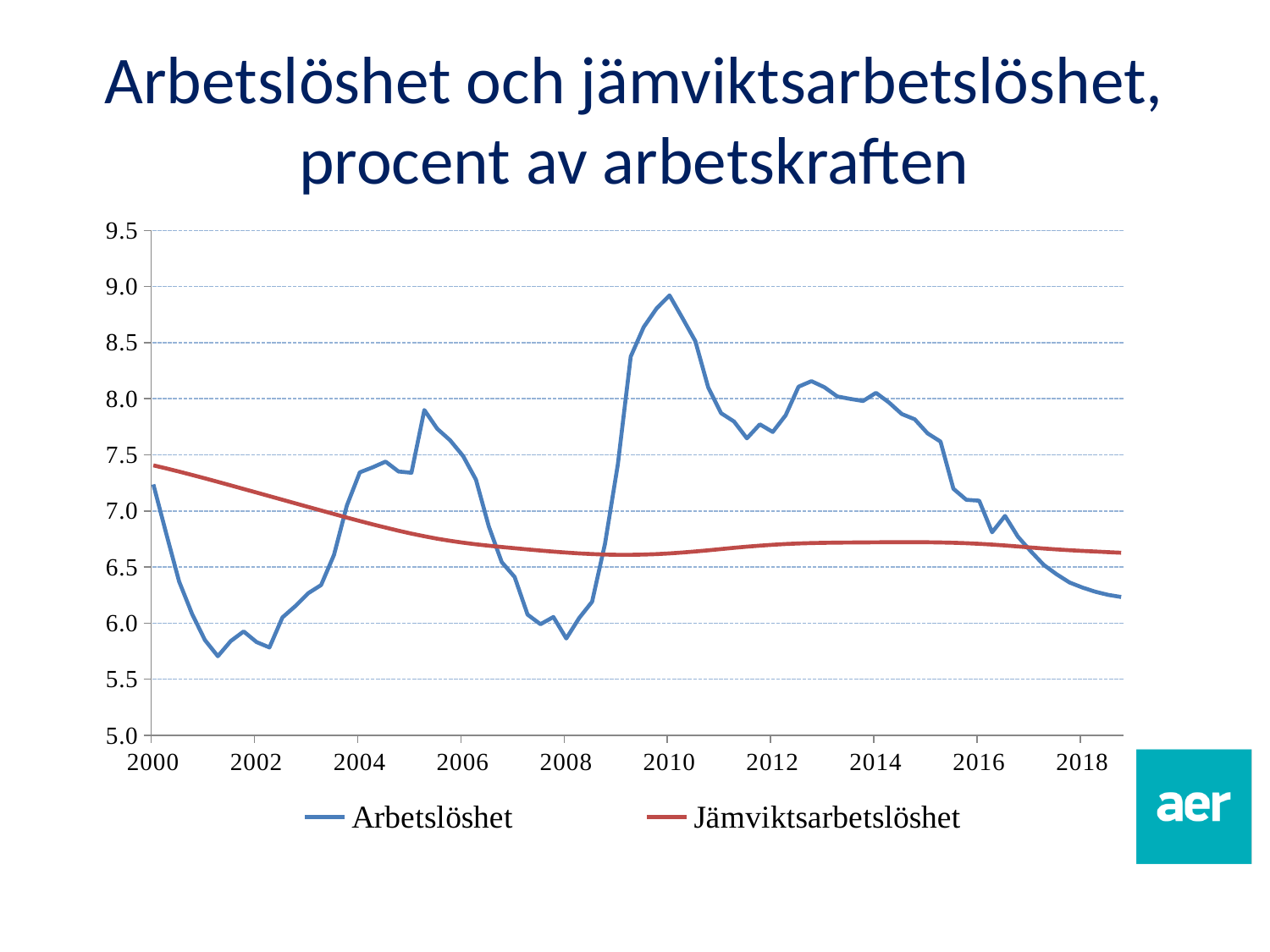
Which colour is the Jämviktsarbetslöshet line? Red In 2002, which series has the higher value, Arbetslöshet or Jämviktsarbetslöshet? Jämviktsarbetslöshet What are the two series named in the legend? Arbetslöshet and Jämviktsarbetslöshet Is the value for Arbetslöshet in 2008 greater or less than 6.5? less In 2010, which series has the higher value, Arbetslöshet or Jämviktsarbetslöshet? Arbetslöshet Around which year does the Arbetslöshet line reach its highest point? 2010 Does the Jämviktsarbetslöshet line rise or fall between 2000 and 2008? Fall How many series does the legend list? 2 Is the value for Jämviktsarbetslöshet in 2000 greater or less than 7.0? greater What kind of chart is shown on the slide? Line chart Is the value for Jämviktsarbetslöshet in 2018 greater or less than 7.0? less